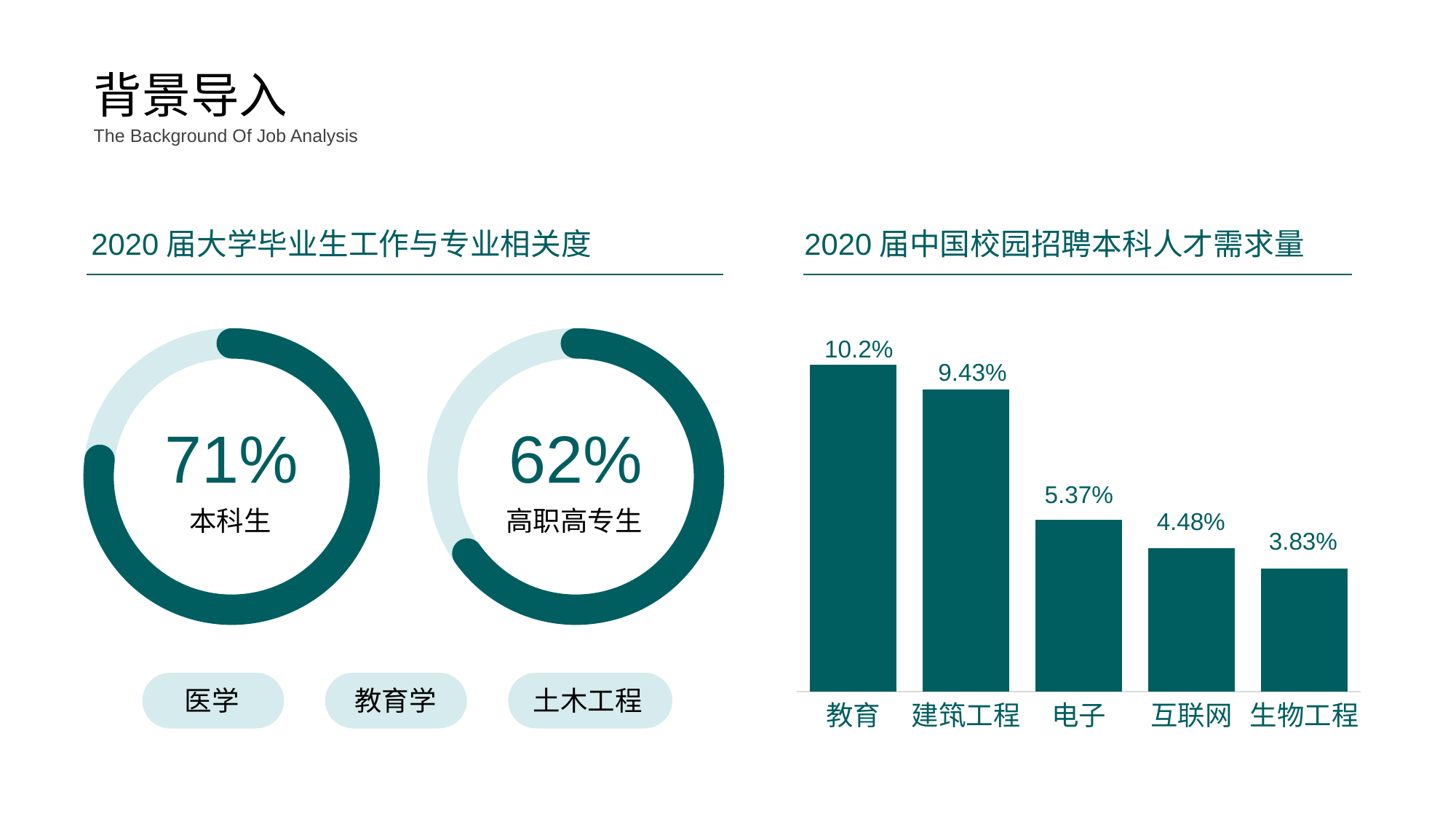
In the bar chart titled 2020届中国校园招聘本科人才需求量, what is the difference between the values for 教育 and 建筑工程? 0.77% In the bar chart titled 2020届中国校园招聘本科人才需求量, do the values rise or fall from left to right? fall What kind of chart is the chart titled 2020届中国校园招聘本科人才需求量? bar chart In the bar chart titled 2020届中国校园招聘本科人才需求量, what is the value for 教育? 10.2% In the ring charts under 2020届大学毕业生工作与专业相关度, what is the difference between the values for 本科生 and 高职高专生? 9% How many categories are shown in the bar chart titled 2020届中国校园招聘本科人才需求量? 5 In the bar chart titled 2020届中国校园招聘本科人才需求量, which is larger, the value for 电子 or the value for 互联网? 电子 In the bar chart titled 2020届中国校园招聘本科人才需求量, which category has the highest value? 教育 In the ring charts under 2020届大学毕业生工作与专业相关度, what is the value shown for 本科生? 71% In the bar chart titled 2020届中国校园招聘本科人才需求量, what is the value for 互联网? 4.48% In the bar chart titled 2020届中国校园招聘本科人才需求量, which category has the lowest value? 生物工程 In the bar chart titled 2020届中国校园招聘本科人才需求量, what is the difference between the values for 电子 and 生物工程? 1.54%